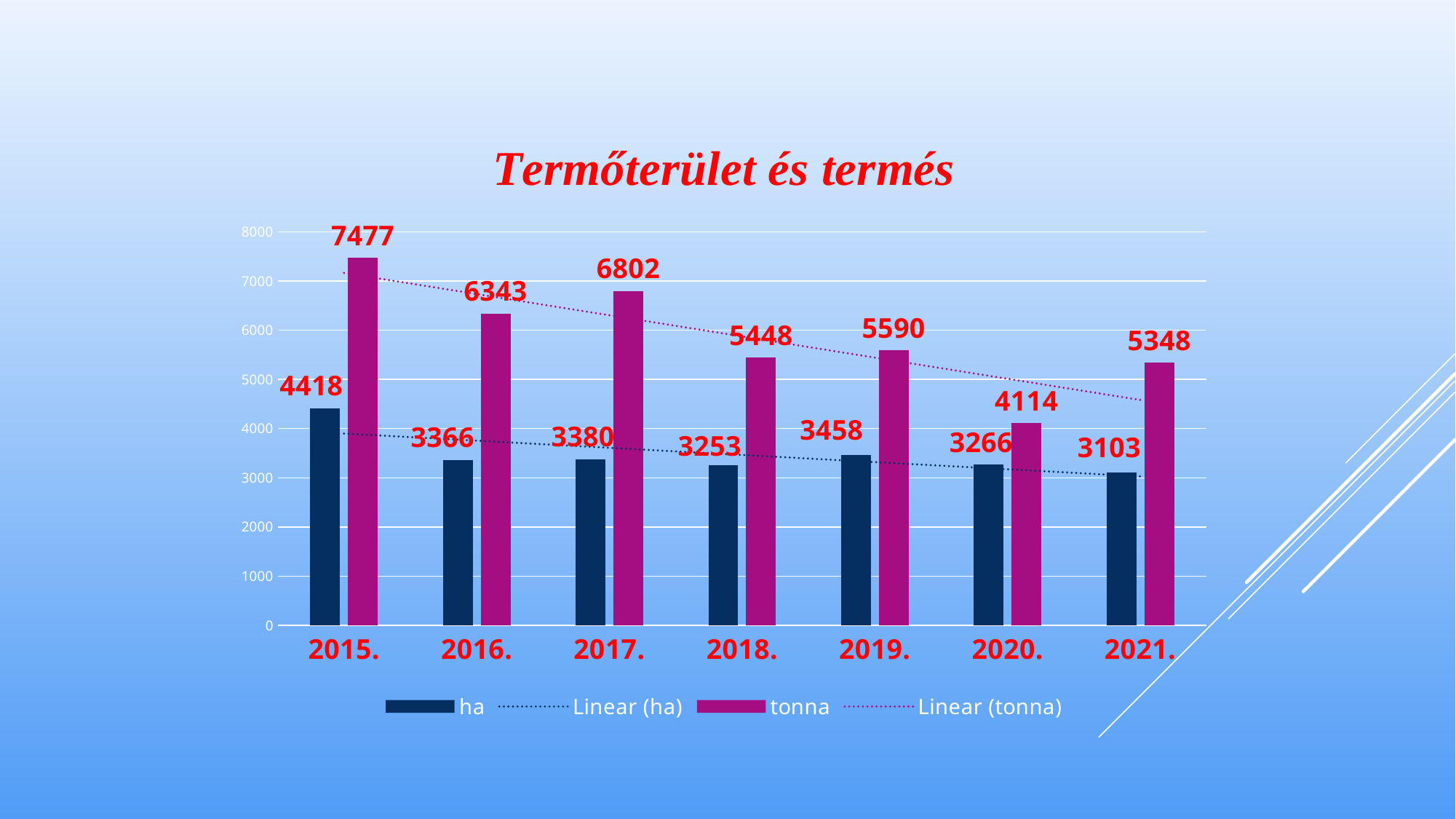
What is the value of the tonna series for 2020.? 4114 Which year has the highest tonna value? 2015. How many years are shown on the x axis? 7 Which year has the lowest ha value? 2021. What kind of chart is shown on the slide? bar chart What is the value of the ha series for 2021.? 3103 Which year has the lowest tonna value? 2020. What is the difference between the tonna values for 2015. and 2016.? 1134 Which is larger, the tonna value for 2019. or for 2018.? 2019. What is the value of the ha series for 2015.? 4418 What is the title of the chart? Termőterület és termés How many entries does the legend list? 4